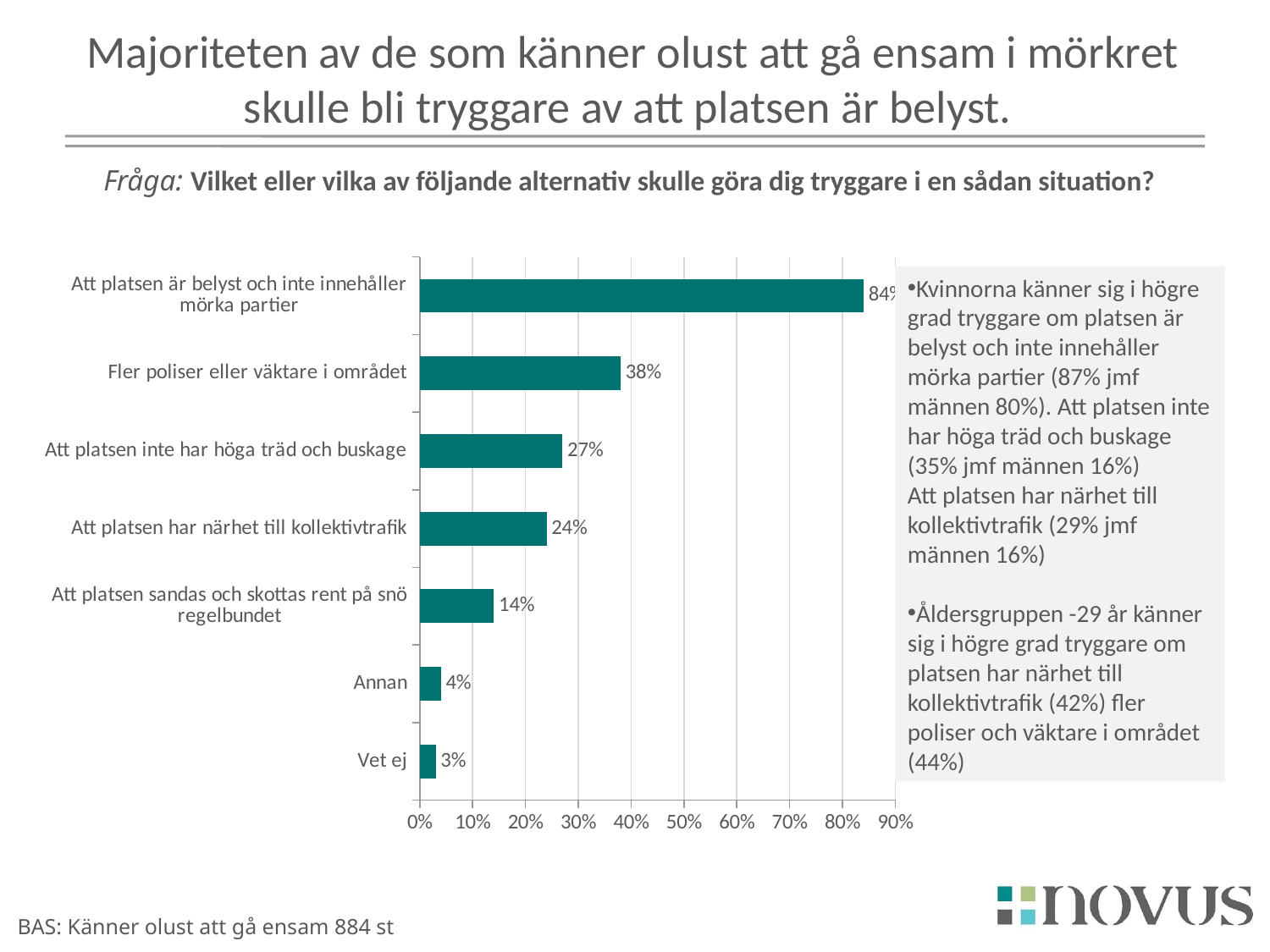
Which is larger: the value for "Annan" or the value for "Vet ej"? Annan Which category has the lowest value in the chart? Vet ej What is the value for "Att platsen inte har höga träd och buskage"? 27% What type of chart is shown on the slide? bar chart What is the difference between the values for "Fler poliser eller väktare i området" and "Att platsen inte har höga träd och buskage"? 11% What is the value for "Att platsen har närhet till kollektivtrafik"? 24% How many categories are shown in the chart? 7 What percentage of respondents chose "Fler poliser eller väktare i området"? 38% What percentage is shown for "Att platsen sandas och skottas rent på snö regelbundet"? 14% Which category has the highest value in the chart? Att platsen är belyst och inte innehåller mörka partier What is the highest value shown on the chart's percentage axis? 90% Is the value for "Att platsen är belyst och inte innehåller mörka partier" greater or less than 80%? greater